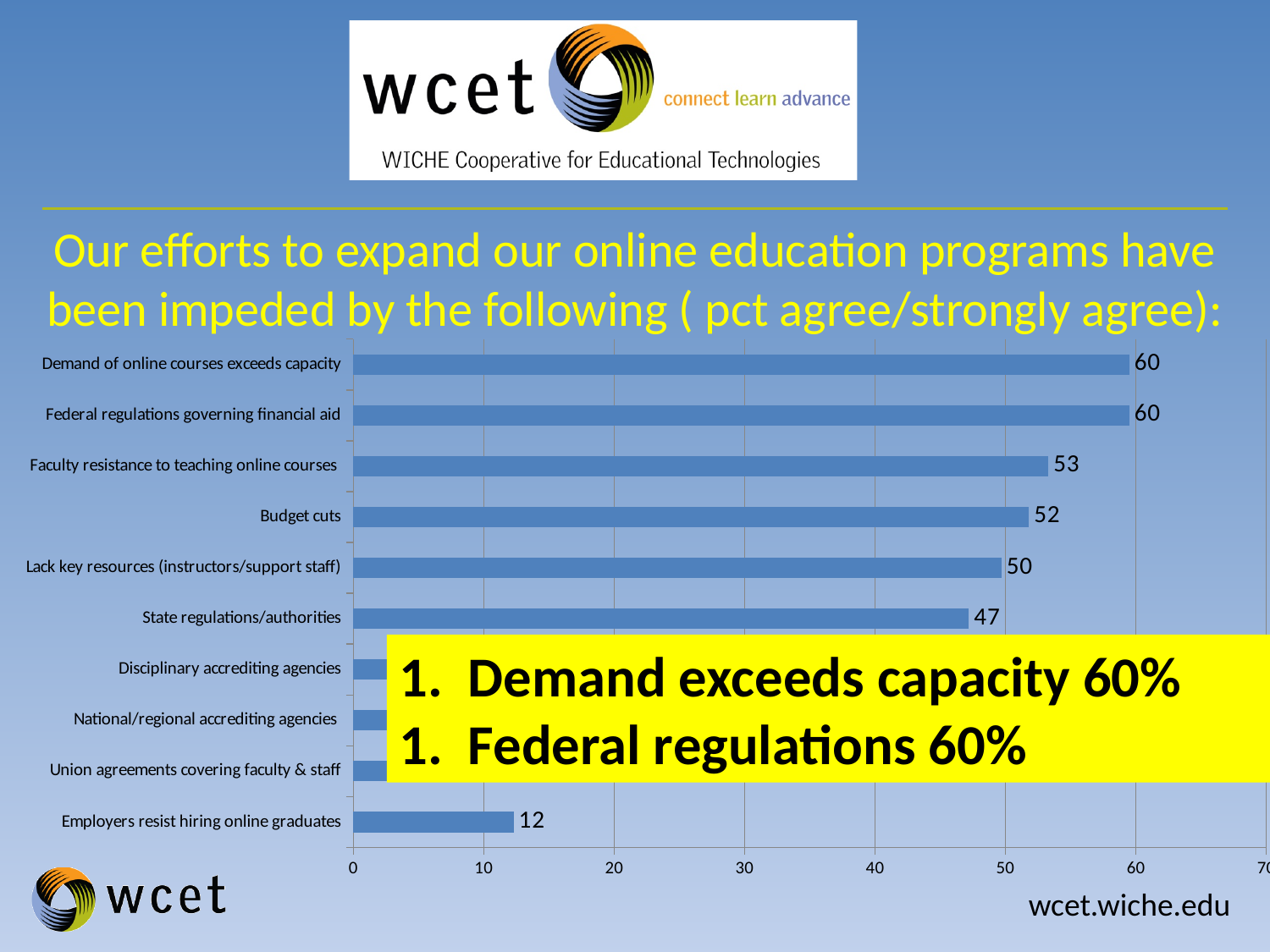
What is the value for "State regulations/authorities"? 47 How many categories are shown in the chart? 10 What is the difference between the values for "Federal regulations governing financial aid" and "Employers resist hiring online graduates"? 48 What is the value for "Employers resist hiring online graduates"? 12 Which has a larger value, "Budget cuts" or "State regulations/authorities"? Budget cuts What is the value for "Budget cuts"? 52 Is the value for "Faculty resistance to teaching online courses" greater or less than 50? greater Which two categories share the highest value of 60? Demand of online courses exceeds capacity; Federal regulations governing financial aid What is the value for "Demand of online courses exceeds capacity"? 60 What kind of chart is shown on the slide? bar chart What is the value for "Faculty resistance to teaching online courses"? 53 What is the difference between the values for "Lack key resources (instructors/support staff)" and "State regulations/authorities"? 3